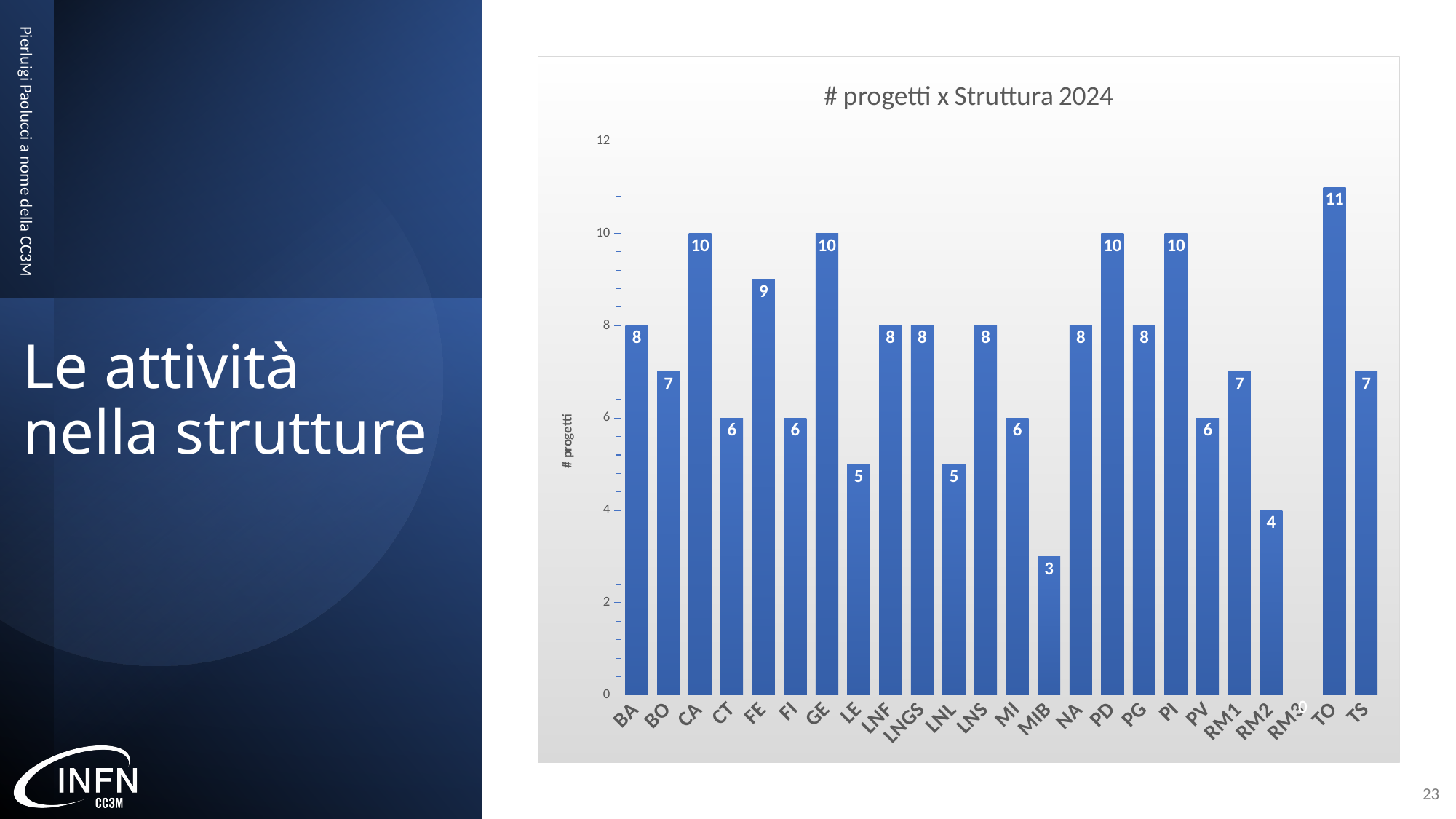
How many structures (categories) are shown on the x axis? 24 What is the difference between the values for TO and MIB? 8 What is the value for TO in the '# progetti x Struttura 2024' chart? 11 What kind of chart is shown on the slide? Bar chart Which has a larger value, BO or LE? BO Which structure has the lowest number of projects? RM3 What is the difference between the values for CA and CT? 4 Which structure has the highest number of projects? TO How many projects does FE have in the chart? 9 What is the value for RM2? 4 What is the title of the chart? # progetti x Struttura 2024 What is the value shown for MIB? 3